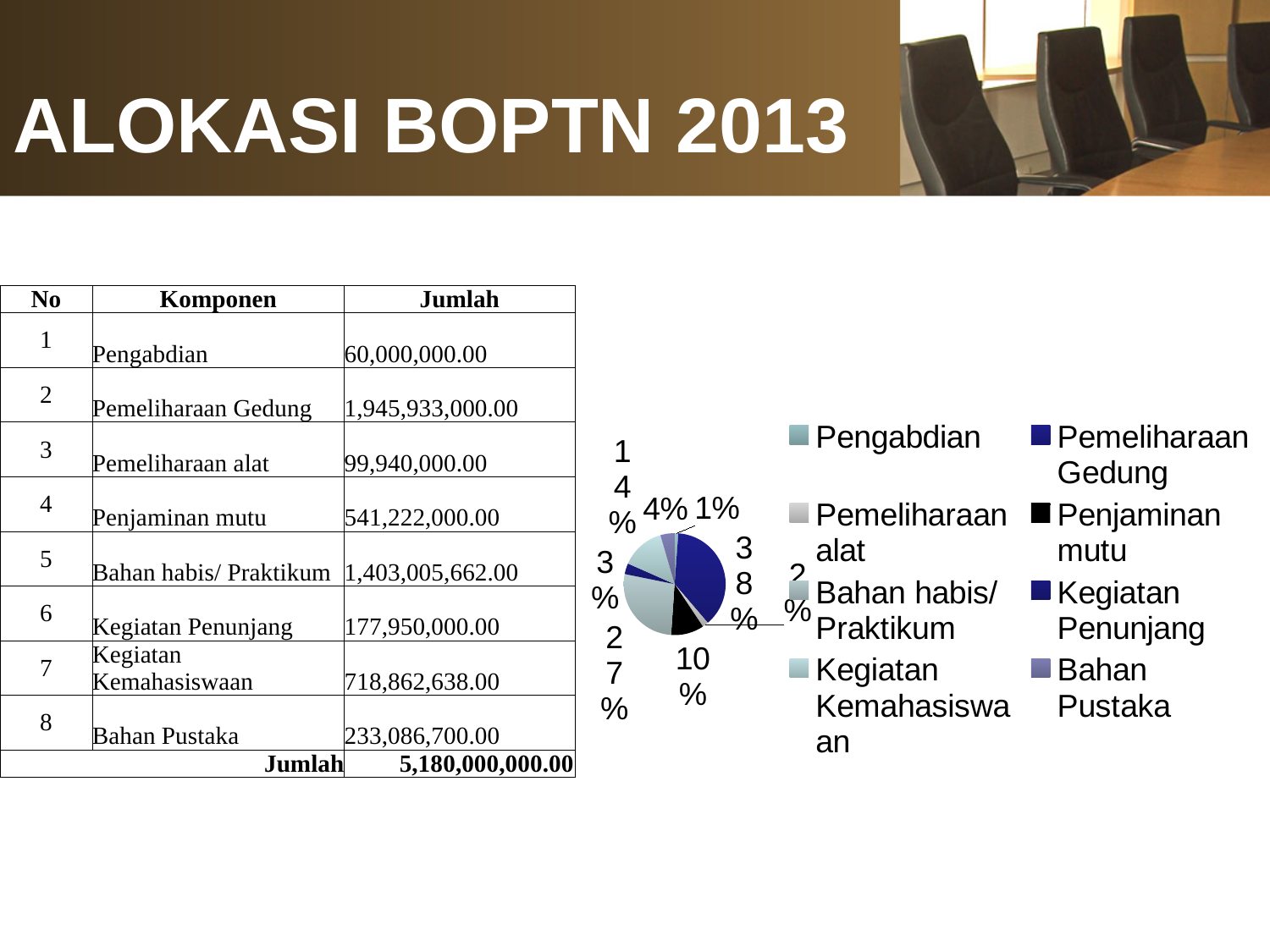
Which category has the largest slice of the pie chart? Pemeliharaan Gedung Which is larger in the pie chart, Pemeliharaan Gedung or Bahan habis/ Praktikum? Pemeliharaan Gedung What share of the pie does Kegiatan Kemahasiswaan represent? 14% What share of the pie does Penjaminan mutu represent? 10% What is the title of the slide containing the pie chart? ALOKASI BOPTN 2013 Which category has the smallest slice of the pie chart? Pengabdian Which legend entry is shown in black in the pie chart? Penjaminan mutu How many categories does the pie chart's legend list? 8 What share of the pie does Bahan habis/ Praktikum represent? 27% What kind of chart is shown on the slide? pie chart What is the difference in percentage points between the Pemeliharaan Gedung slice and the Penjaminan mutu slice? 28